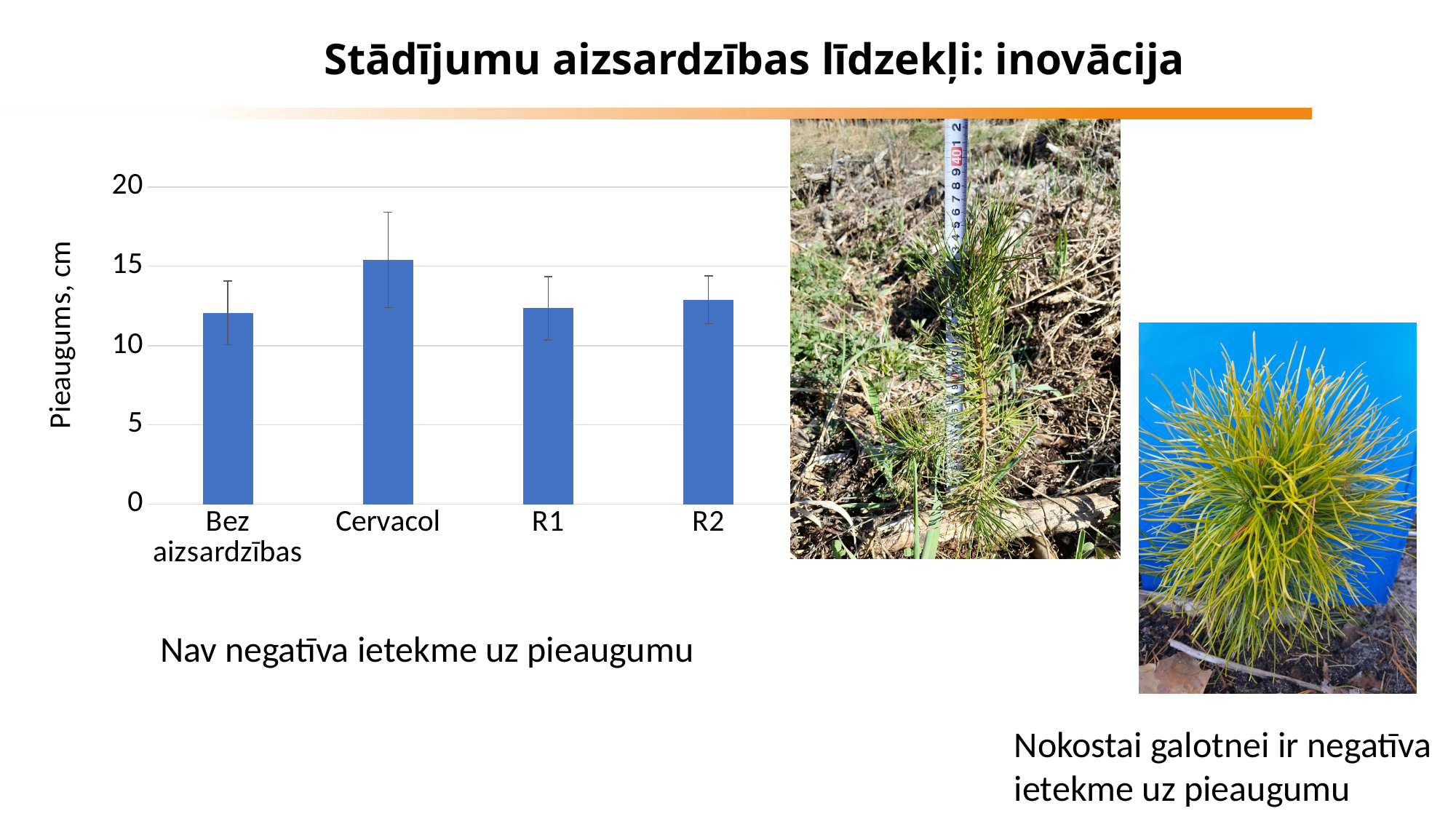
Is the value for R2 greater or less than 15? less What is the label of the y axis of the chart? Pieaugums, cm Is the value for R1 greater or less than 10? greater What kind of chart is shown on the slide? bar chart Which is larger, the value for Cervacol or the value for R2? Cervacol Which category has the highest value in the chart? Cervacol Is the value for Cervacol greater or less than 10? greater Which is larger, the value for Cervacol or the value for R1? Cervacol How many categories are shown on the x axis of the chart? 4 What is the highest value shown on the y axis of the chart? 20